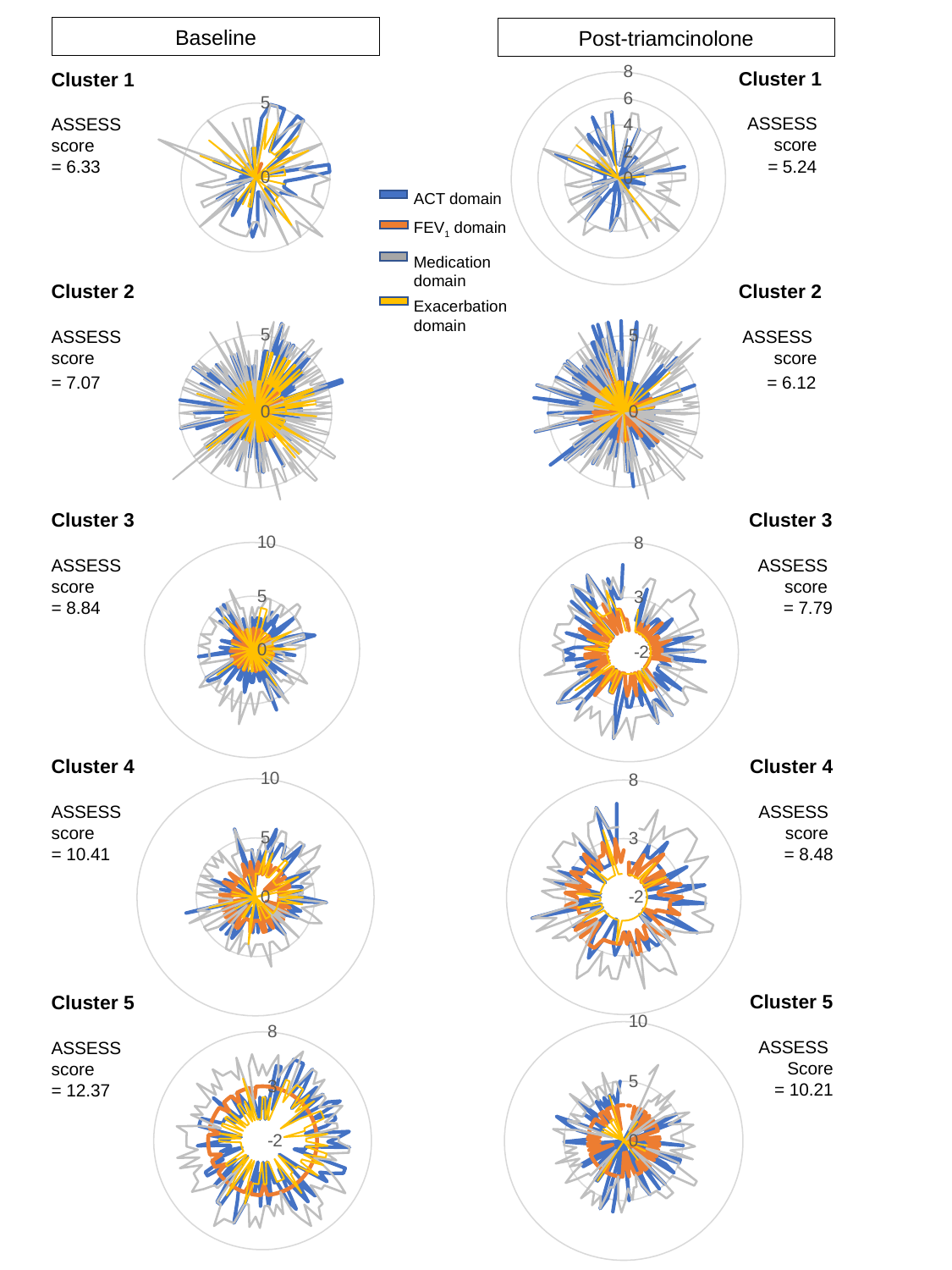
What is the ASSESS score for Cluster 5 at Baseline? 12.37 How many clusters are shown in the Baseline column? 5 How many series does the legend list? 4 What is the difference between the Baseline and Post-triamcinolone ASSESS scores for Cluster 4? 1.93 What is the ASSESS score for Cluster 3 Post-triamcinolone? 7.79 Which cluster has the lowest ASSESS score Post-triamcinolone? Cluster 1 Which cluster has the highest ASSESS score at Baseline? Cluster 5 What kind of chart is used for each cluster on the slide? Radar chart What is the ASSESS score for Cluster 1 at Baseline? 6.33 Is the Baseline ASSESS score for Cluster 2 larger or smaller than its Post-triamcinolone ASSESS score? Larger What is the title of the right-hand column of charts? Post-triamcinolone Which series is shown in orange in the legend? FEV1 domain